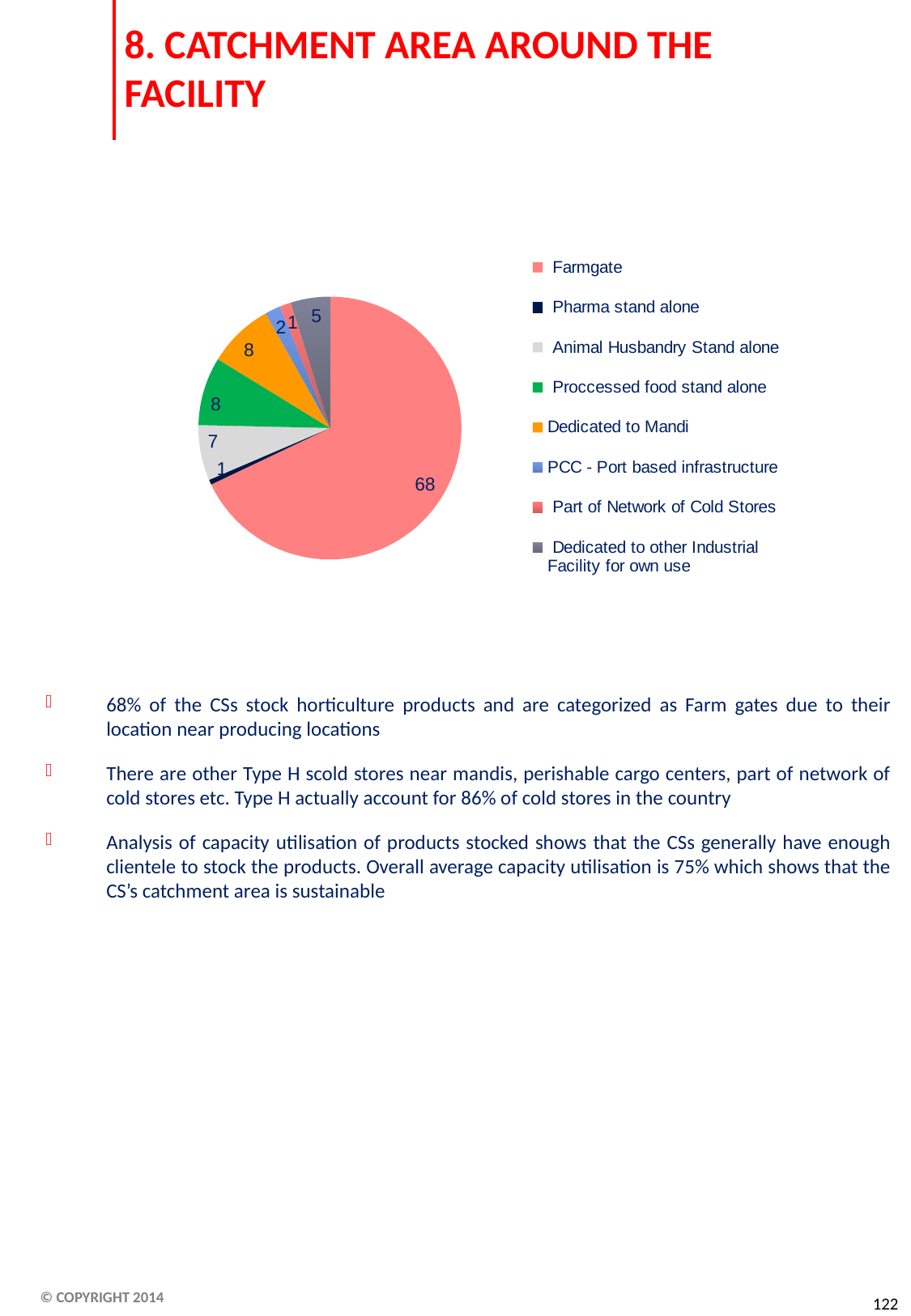
What colour is the Farmgate slice in the pie chart? pink What is the value for Dedicated to other Industrial Facility for own use? 5 What is the value for Farmgate in the pie chart? 68 What is the value for Animal Husbandry Stand alone? 7 What kind of chart is shown on the slide? pie chart Which is larger, the value for Animal Husbandry Stand alone or the value for Dedicated to other Industrial Facility for own use? Animal Husbandry Stand alone How many categories does the pie chart have? 8 Which category has the largest slice of the pie? Farmgate What is the difference between the values for Farmgate and Proccessed food stand alone? 60 What is the value for Dedicated to Mandi? 8 What is the value for PCC - Port based infrastructure? 2 What is the difference between the values for Dedicated to Mandi and PCC - Port based infrastructure? 6